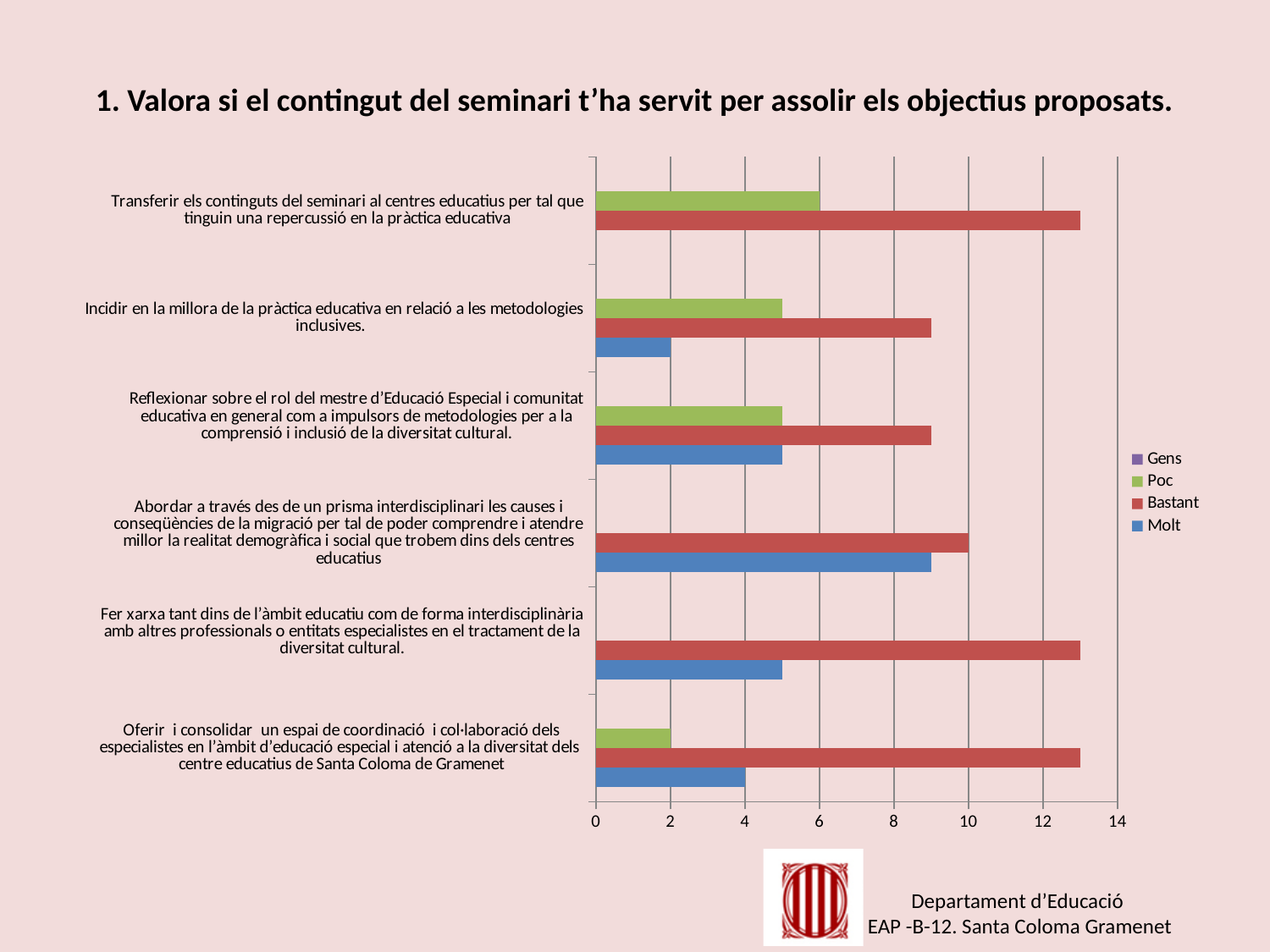
Is the Molt value for 'Reflexionar sobre el rol del mestre d'Educació Especial...' greater or less than 6? less Which series has the lowest value for 'Oferir i consolidar un espai de coordinació...' among the bars shown? Poc What is the value of the Molt series for 'Incidir en la millora de la pràctica educativa en relació a les metodologies inclusives.'? 2 How many categories (objectives) are plotted on the chart? 6 Is the Bastant value for 'Transferir els continguts del seminari al centres educatius...' greater or less than 12? greater What is the value of the Poc series for 'Transferir els continguts del seminari al centres educatius per tal que tinguin una repercussió en la pràctica educativa'? 6 What kind of chart is shown on the slide? bar chart What is the value of the Bastant series for 'Abordar a través des de un prisma interdisciplinari les causes i conseqüències de la migració...'? 10 What is the value of the Molt series for 'Oferir i consolidar un espai de coordinació i col·laboració dels especialistes...'? 4 How many series does the legend list? 4 For 'Fer xarxa tant dins de l'àmbit educatiu...', which series has the larger value, Bastant or Molt? Bastant Which colour represents the Bastant series in the legend? red